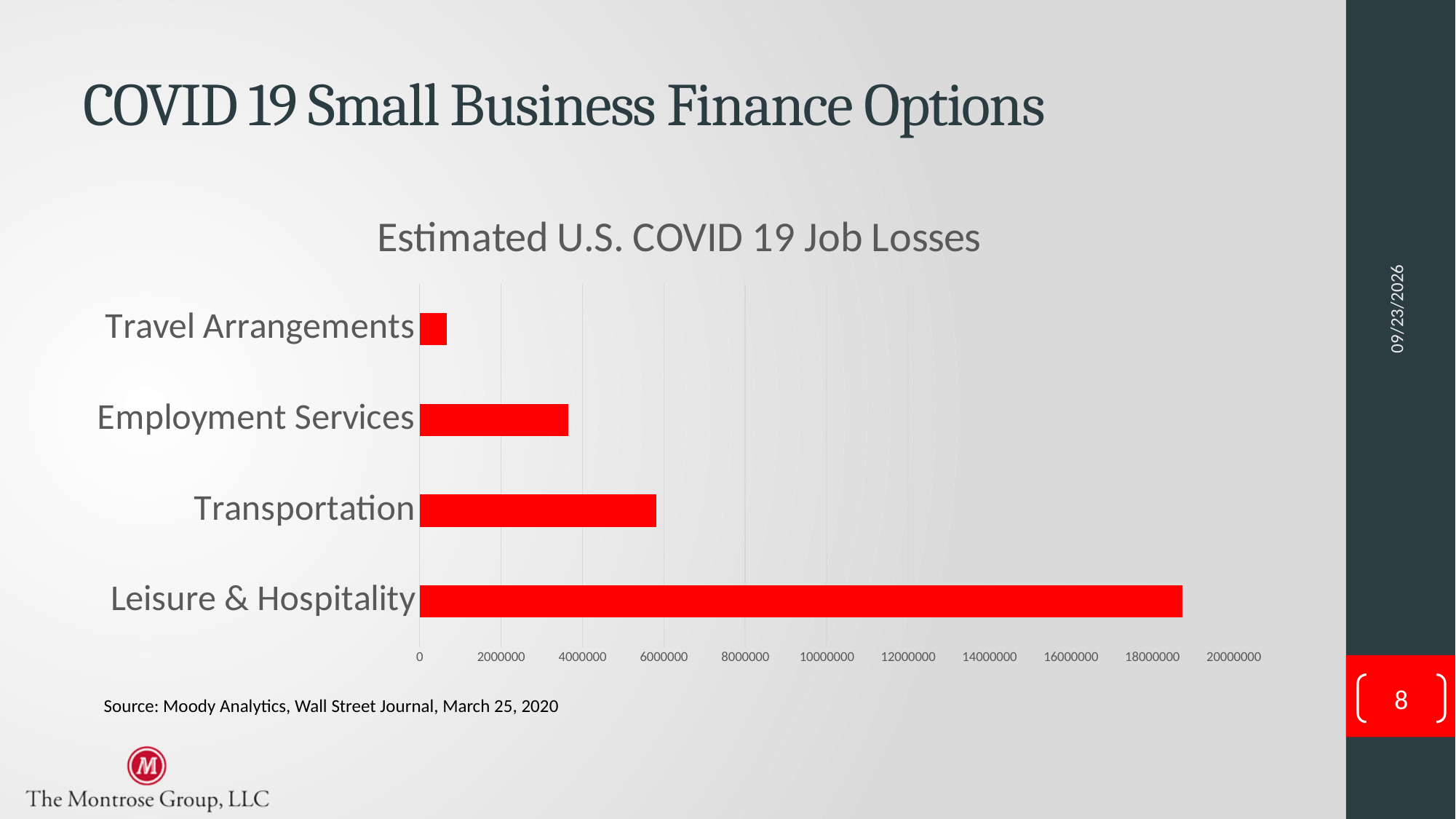
Is the value for Transportation greater or less than 4000000? greater Which has lower estimated job losses, Travel Arrangements or Employment Services? Travel Arrangements Is the value for Travel Arrangements greater or less than 2000000? less Which has higher estimated job losses, Transportation or Employment Services? Transportation How many categories are plotted in the chart? 4 What is the title of the chart? Estimated U.S. COVID 19 Job Losses Is the value for Employment Services greater or less than 4000000? less What colour are the bars in the chart? red Which category has the highest estimated job losses? Leisure & Hospitality What kind of chart is shown on the slide? bar chart Which category has the lowest estimated job losses? Travel Arrangements